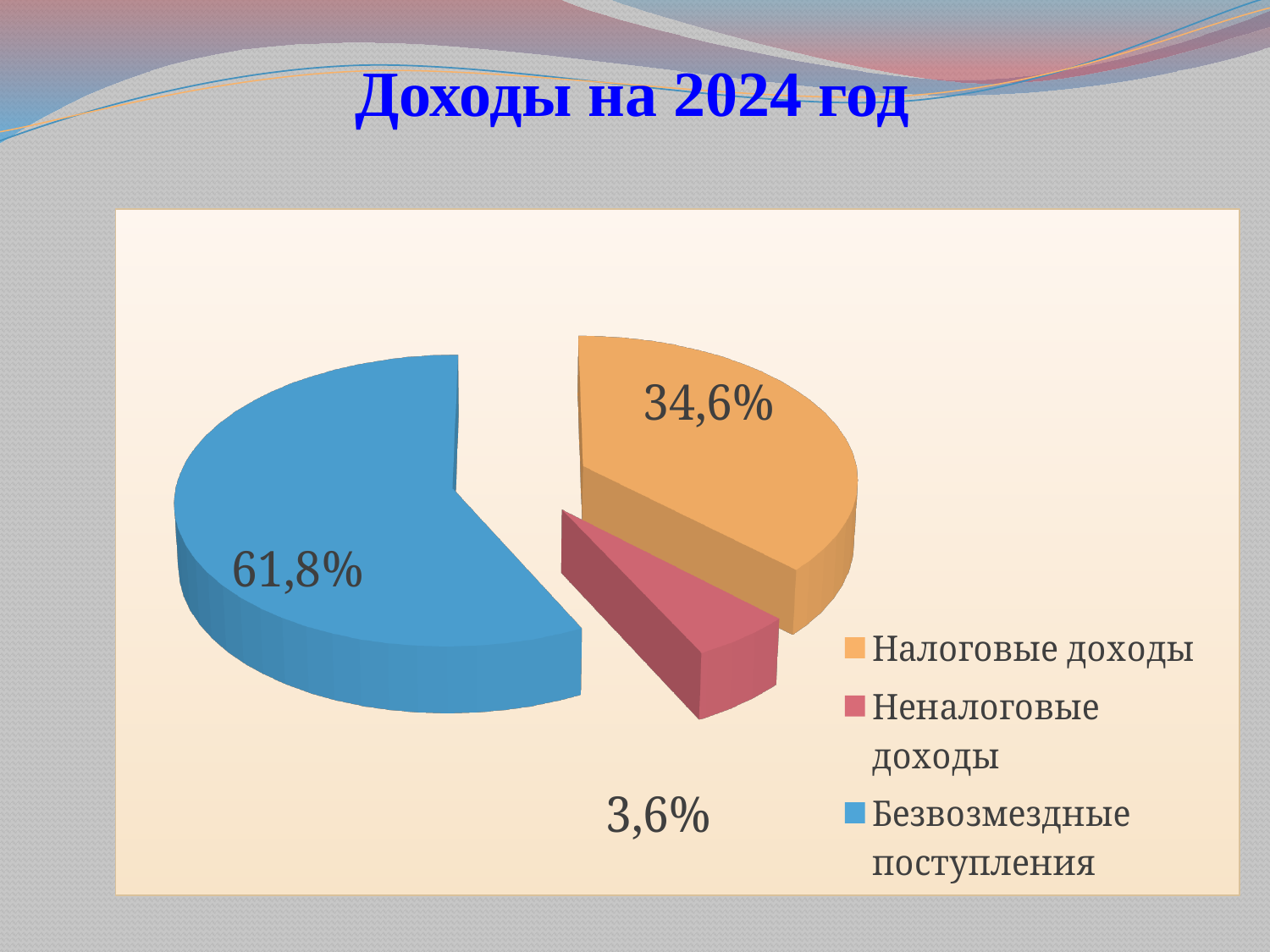
What kind of chart is shown on the slide? pie chart Which category has the largest slice of the pie? Безвозмездные поступления How many slices does the pie chart have? 3 What is the title of the slide? Доходы на 2024 год What share of the pie does Налоговые доходы represent? 34,6% What colour is the slice for Неналоговые доходы? red What is the difference in percentage points between Налоговые доходы and Неналоговые доходы? 31 What is the difference in percentage points between Безвозмездные поступления and Налоговые доходы? 27,2 Which category has the smallest slice of the pie? Неналоговые доходы What share of the pie does Безвозмездные поступления represent? 61,8% What share of the pie does Неналоговые доходы represent? 3,6% Which is larger, Налоговые доходы or Неналоговые доходы? Налоговые доходы